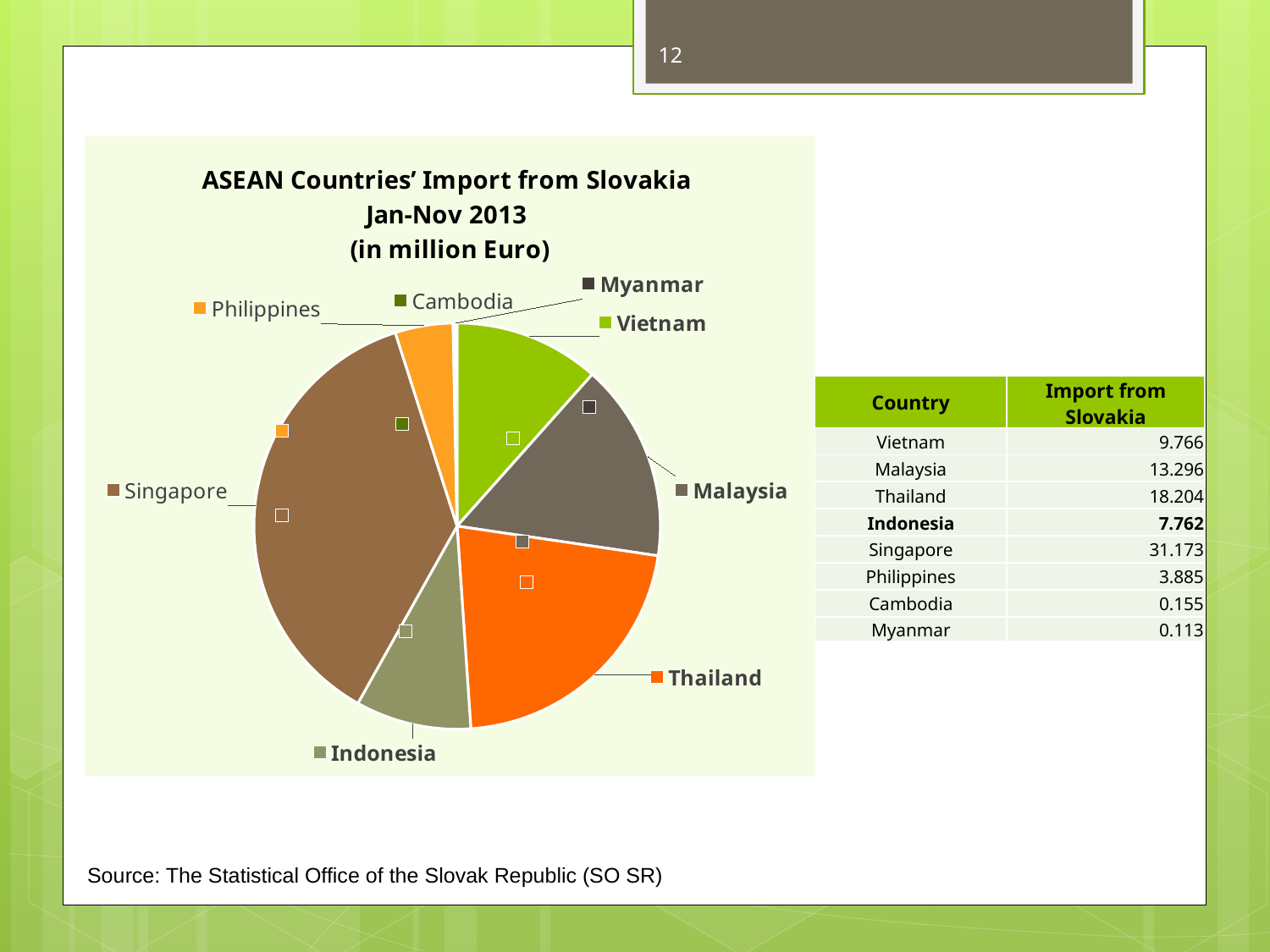
How many countries are shown in the pie chart? 8 Which country has the smallest import from Slovakia according to the table? Myanmar What is the import from Slovakia for Singapore, as shown in the table? 31.173 What is the import from Slovakia for Cambodia, as shown in the table? 0.155 What unit are the values in the pie chart expressed in, according to its title? million Euro What kind of chart is shown on the slide? pie chart What is the difference between the import values for Singapore and Thailand in the table? 12.969 What is the import from Slovakia for Thailand, as shown in the table? 18.204 What is the difference between the import values for Thailand and Indonesia in the table? 10.442 What is the title of the pie chart? ASEAN Countries' Import from Slovakia Jan-Nov 2013 (in million Euro) Which country has the largest slice of the pie chart? Singapore Which is larger, the import from Slovakia for Malaysia or for Vietnam? Malaysia